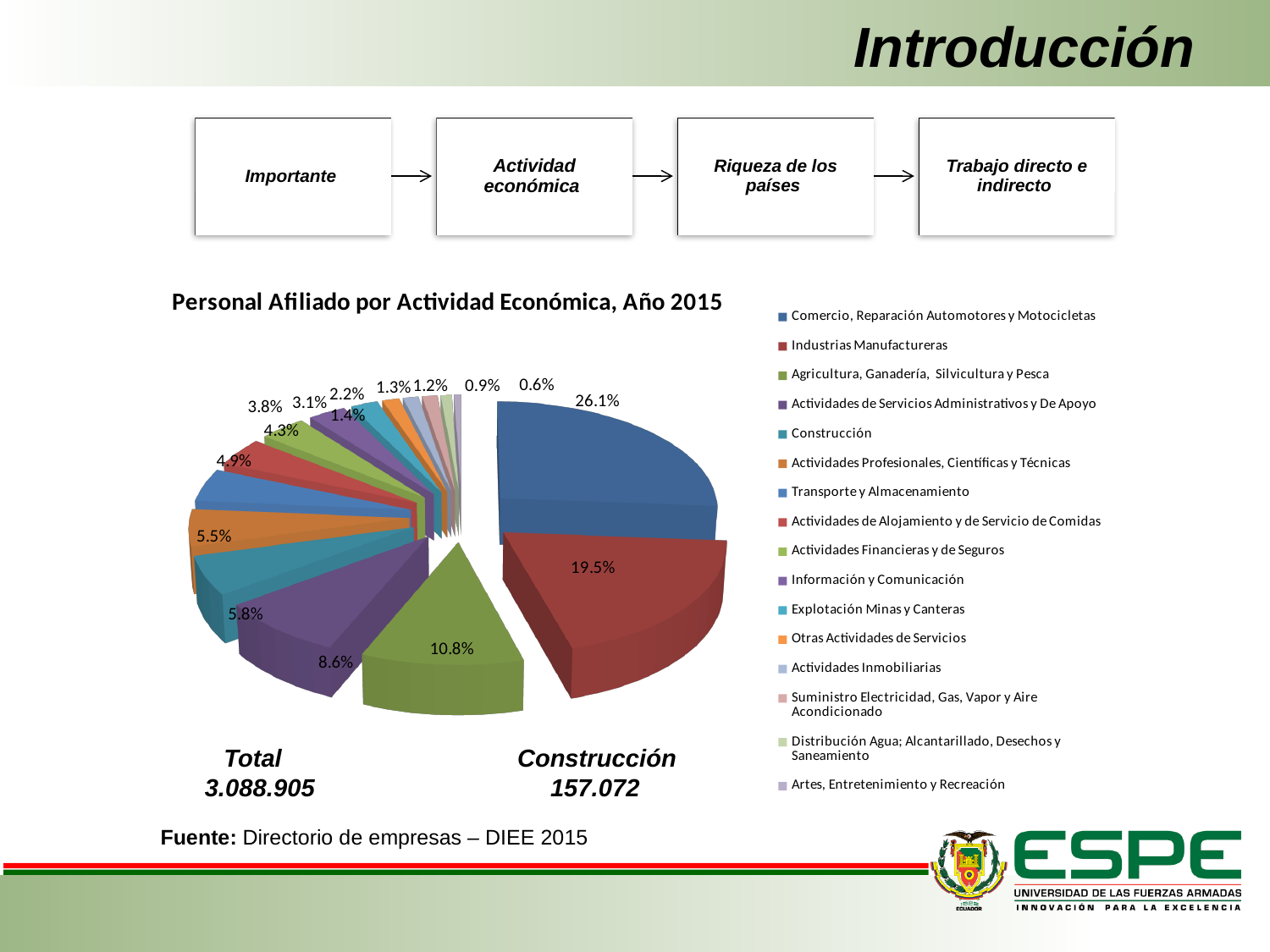
How many categories does the legend of the pie chart list? 16 Which slice is larger: Agricultura, Ganadería, Silvicultura y Pesca or Actividades de Servicios Administrativos y De Apoyo? Agricultura, Ganadería, Silvicultura y Pesca What share of the pie does Comercio, Reparación Automotores y Motocicletas have? 26.1% What kind of chart is shown on the slide? Pie chart What share of the pie does Industrias Manufactureras have? 19.5% What is the difference in percentage points between the Comercio slice and the Industrias Manufactureras slice? 6.6 Which activity has the largest share of the pie? Comercio, Reparación Automotores y Motocicletas What share of the pie does Agricultura, Ganadería, Silvicultura y Pesca have? 10.8% What is the title of the pie chart? Personal Afiliado por Actividad Económica, Año 2015 Which activity has the smallest share of the pie? Artes, Entretenimiento y Recreación What total number of affiliated personnel is printed below the pie chart? 3.088.905